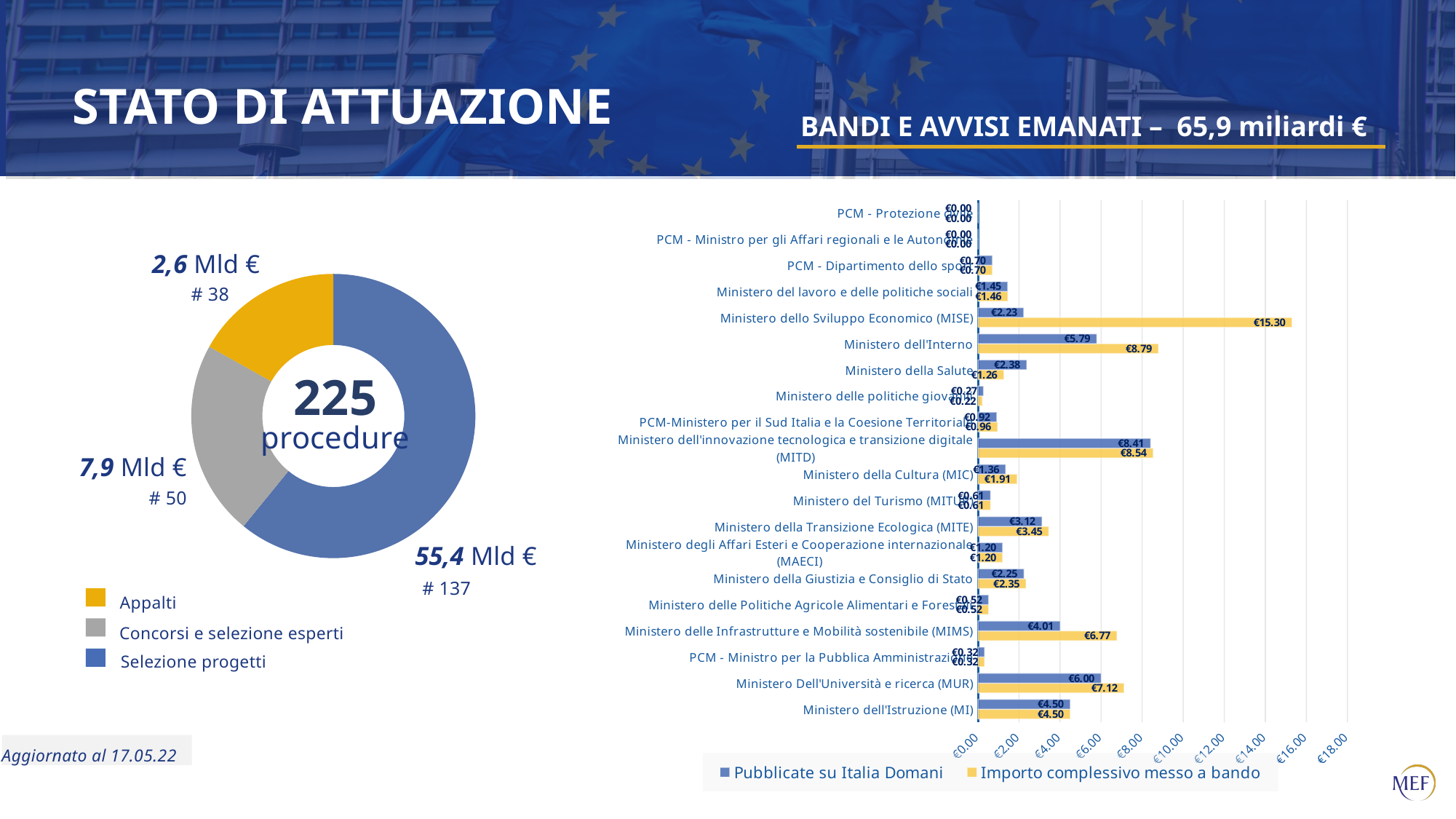
In the bar chart on the right, which ministry has the highest 'Pubblicate su Italia Domani' value? Ministero dell'innovazione tecnologica e transizione digitale (MITD) In the donut chart on the left, how many procedures are counted for 'Appalti'? 38 In the donut chart on the left, what is the total number of procedures shown in the centre? 225 procedure In the bar chart on the right, how many ministries/categories are shown? 20 In the bar chart on the right, what is the difference between the 'Importo complessivo messo a bando' and 'Pubblicate su Italia Domani' values for Ministero delle Infrastrutture e Mobilità sostenibile (MIMS)? €2.76 In the bar chart on the right, what is the 'Pubblicate su Italia Domani' value for Ministero dell'Interno? €5.79 What kind of chart is shown on the left of the slide? Donut (pie) chart In the bar chart on the right, how many series does the legend list? 2 In the bar chart on the right, which ministry has the highest 'Importo complessivo messo a bando' value? Ministero dello Sviluppo Economico (MISE) In the bar chart on the right, which is larger for Ministero della Salute: 'Pubblicate su Italia Domani' or 'Importo complessivo messo a bando'? Pubblicate su Italia Domani In the bar chart on the right, what is the 'Importo complessivo messo a bando' value for Ministero dello Sviluppo Economico (MISE)? €15.30 In the donut chart on the left, what amount is shown for 'Selezione progetti'? 55,4 Mld €